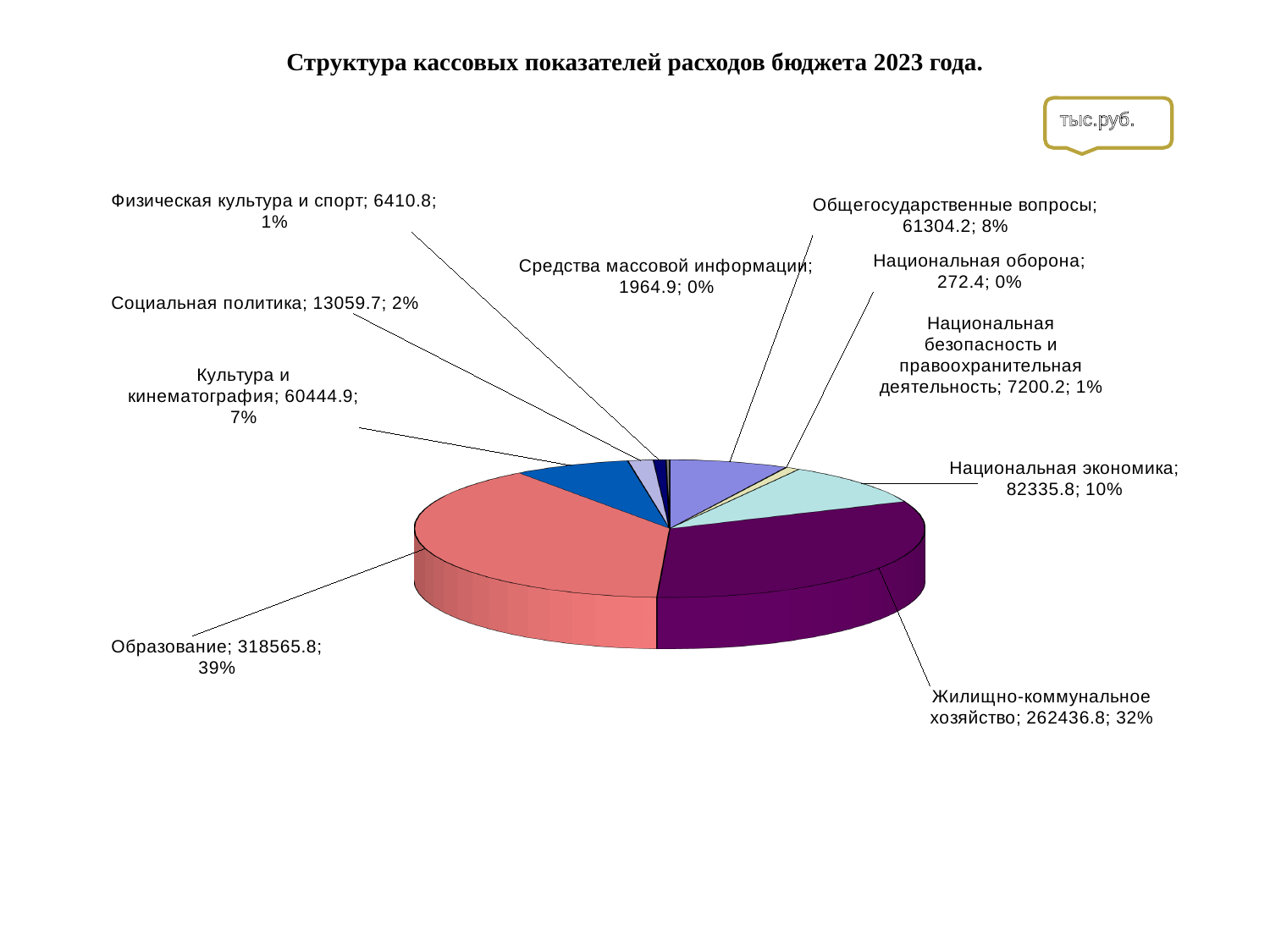
What is the value for Образование? 318565.8 What share of the pie does Жилищно-коммунальное хозяйство represent? 32% Which category has the smallest value? Национальная оборона What share of the pie does Культура и кинематография represent? 7% What is the difference between the values for Образование and Жилищно-коммунальное хозяйство? 56129.0 What kind of chart is shown on the slide? Pie chart What is the value for Жилищно-коммунальное хозяйство? 262436.8 Which is larger, the value for Национальная экономика or the value for Общегосударственные вопросы? Национальная экономика What is the value for Национальная оборона? 272.4 How many categories are shown in the pie chart? 10 Which category has the largest share of the pie? Образование What is the value for Национальная экономика? 82335.8